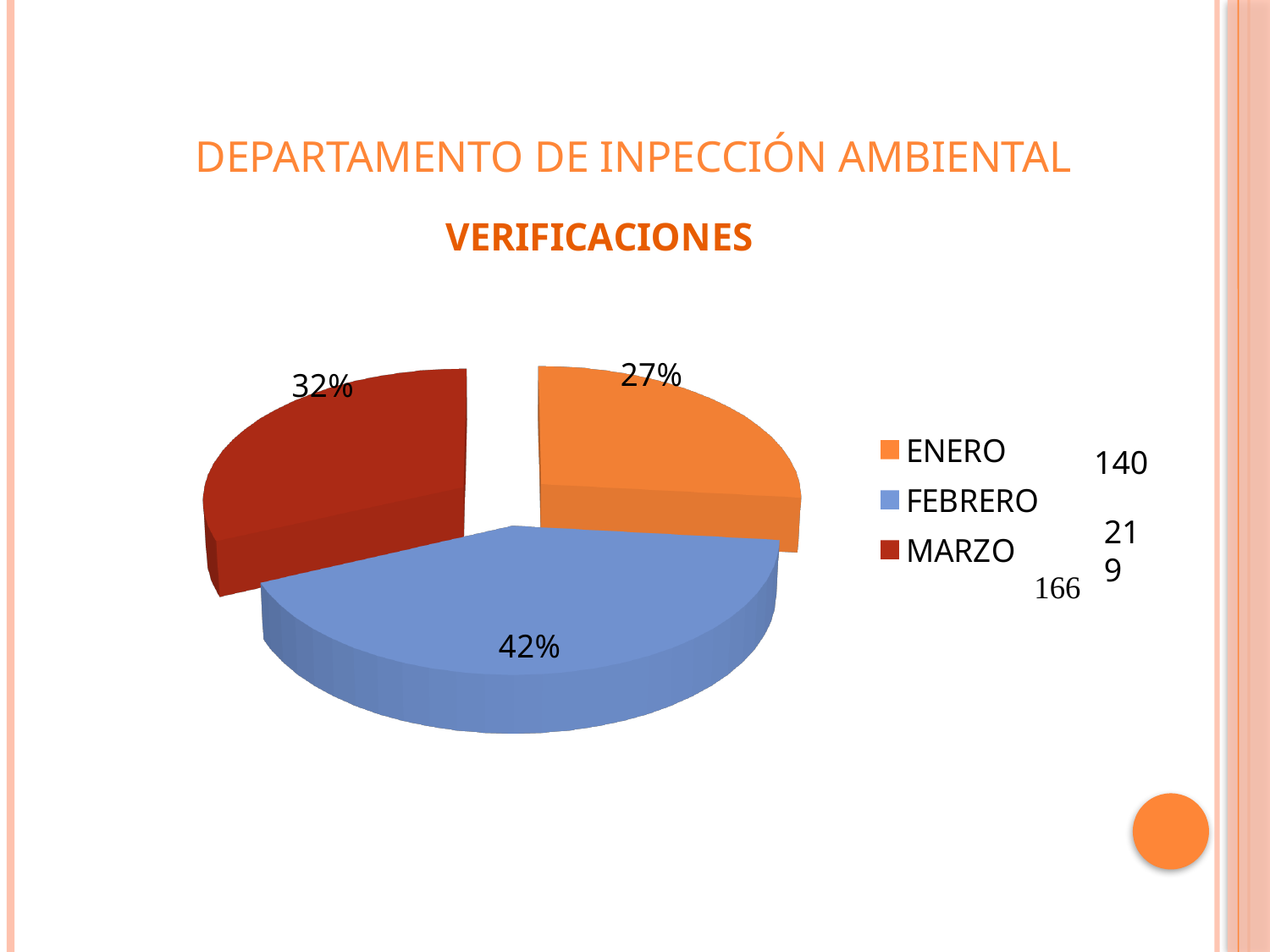
How many entries does the legend list? 3 Which slice is larger, MARZO or ENERO? MARZO Which month has the smallest slice of the pie? ENERO What is the difference in percentage points between the FEBRERO slice and the ENERO slice? 15% What kind of chart is shown on the slide? Pie chart Which month has the largest slice of the pie? FEBRERO What percentage of the pie does MARZO represent? 32% What percentage of the pie does FEBRERO represent? 42% What percentage of the pie does ENERO represent? 27% What colour is the FEBRERO slice? Blue What is the title of the chart? VERIFICACIONES How many slices does the pie chart have? 3